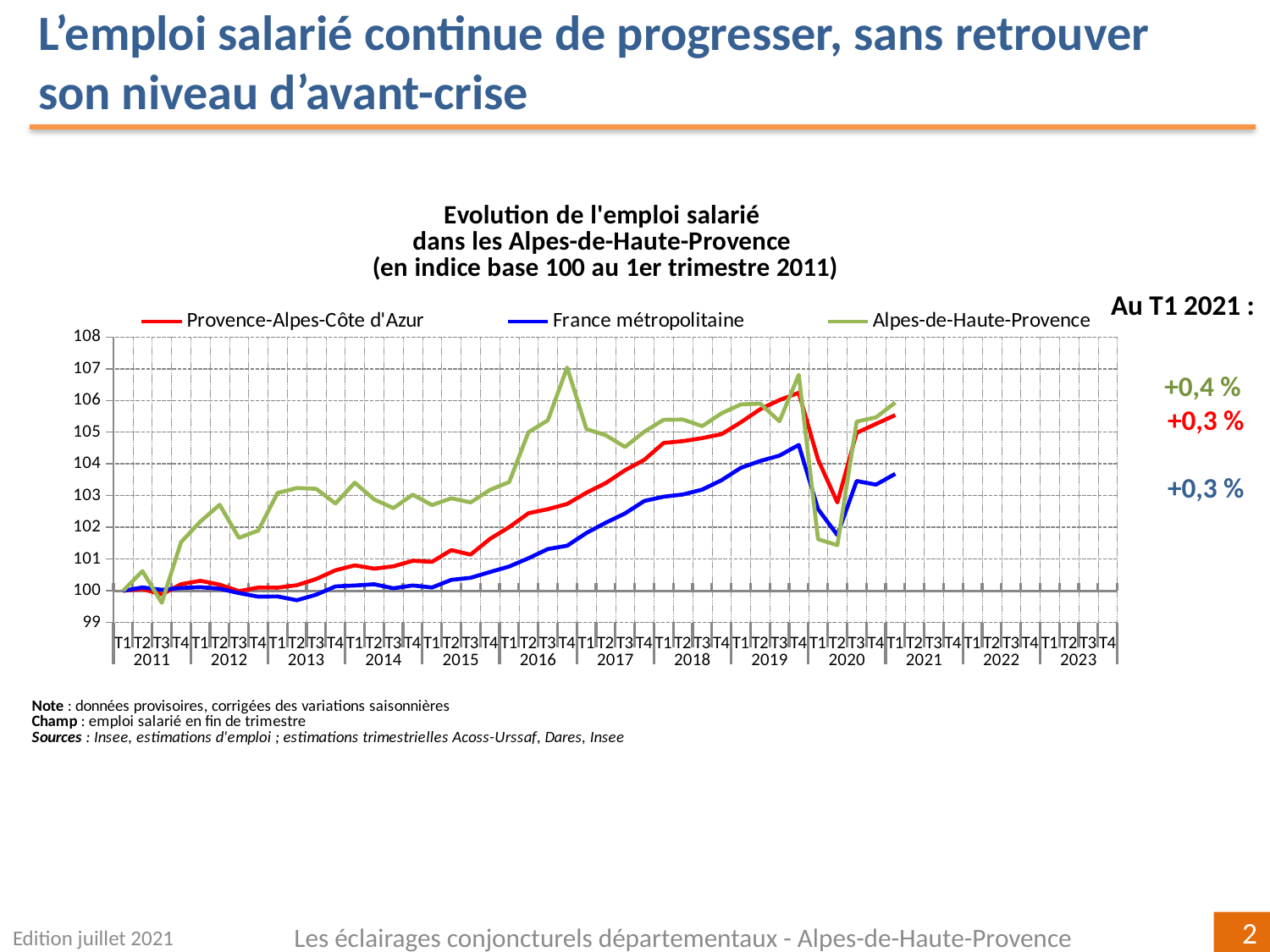
Is the value for Alpes-de-Haute-Provence at T2 2016 greater or less than 106? less Is the value for Alpes-de-Haute-Provence at T2 2020 greater or less than 102? less What is the title of the chart? Evolution de l'emploi salarié dans les Alpes-de-Haute-Provence (en indice base 100 au 1er trimestre 2011) According to the annotation 'Au T1 2021', what is the change shown for Alpes-de-Haute-Provence? +0,4 % Which series has the lowest value at T1 2021? France métropolitaine What kind of chart is shown on the slide? line chart Does the France métropolitaine series rise or fall between 2015 and 2019? rise Is the value for Provence-Alpes-Côte d'Azur at T1 2021 greater or less than 105? greater How many series does the legend list? 3 Which series is drawn in green in the legend? Alpes-de-Haute-Provence At T1 2021, which series is higher: Alpes-de-Haute-Provence or France métropolitaine? Alpes-de-Haute-Provence